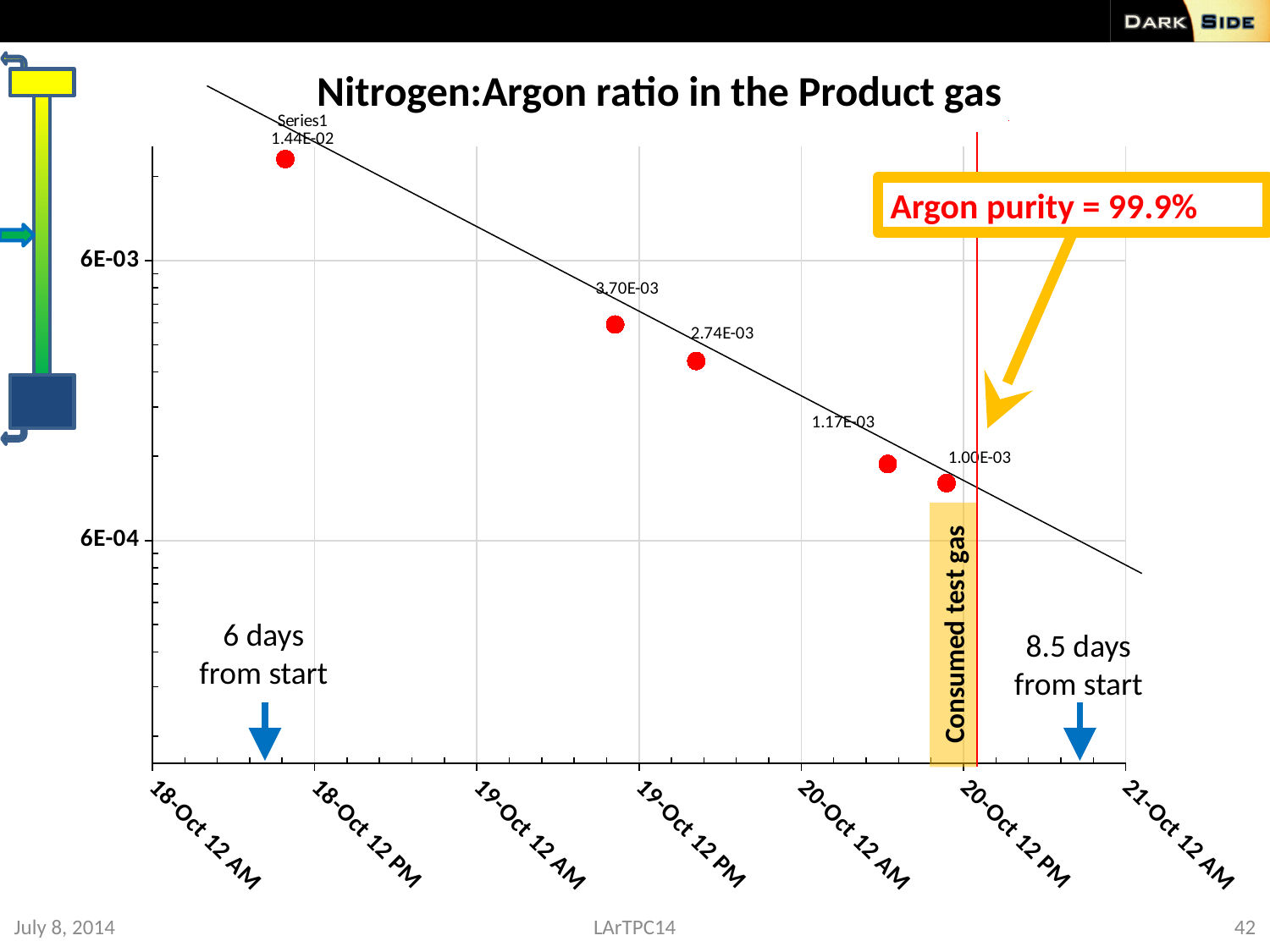
How many data points are plotted on the chart? 5 Do the plotted values rise or fall over time along the x axis? fall What kind of chart is shown on the slide? scatter chart What is the value of the fourth data point from the left? 1.17E-03 What is the highest plotted value on the chart? 1.44E-02 What argon purity is stated in the annotation box on the chart? 99.9% What is the value of the second data point from the left? 3.70E-03 What is the value of the leftmost (first) data point? 1.44E-02 Which is larger, the third data point (2.74E-03) or the fourth data point (1.17E-03)? 2.74E-03 What is the lowest plotted value on the chart? 1.00E-03 What is the value of the rightmost (last) data point? 1.00E-03 What is the title of the chart? Nitrogen:Argon ratio in the Product gas